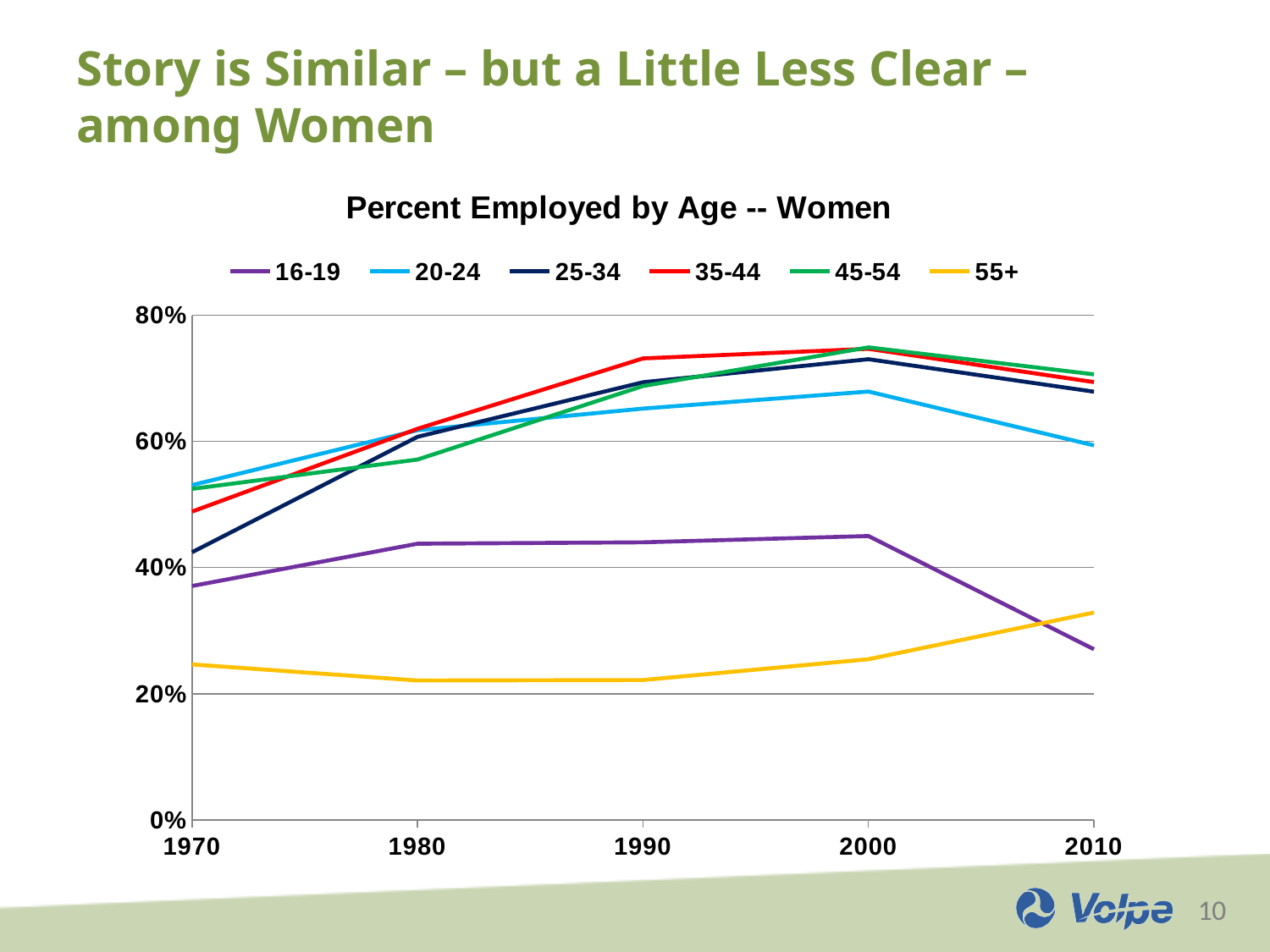
Is the value for the 25-34 group in 1970 greater or less than 60%? less Which age group has the lowest percent employed in 1990? 55+ What is the title of the chart? Percent Employed by Age -- Women What kind of chart is shown on the slide? line chart How many series does the legend list? 6 Is the value for the 35-44 group in 1990 greater or less than 60%? greater Does the 16-19 line rise or fall from 2000 to 2010? fall In 2010, which is larger: the value for 16-19 or the value for 55+? 55+ Is the value for the 55+ group in 1990 greater or less than 40%? less How many years are shown along the x axis? 5 Does the 55+ line rise or fall from 1990 to 2010? rise